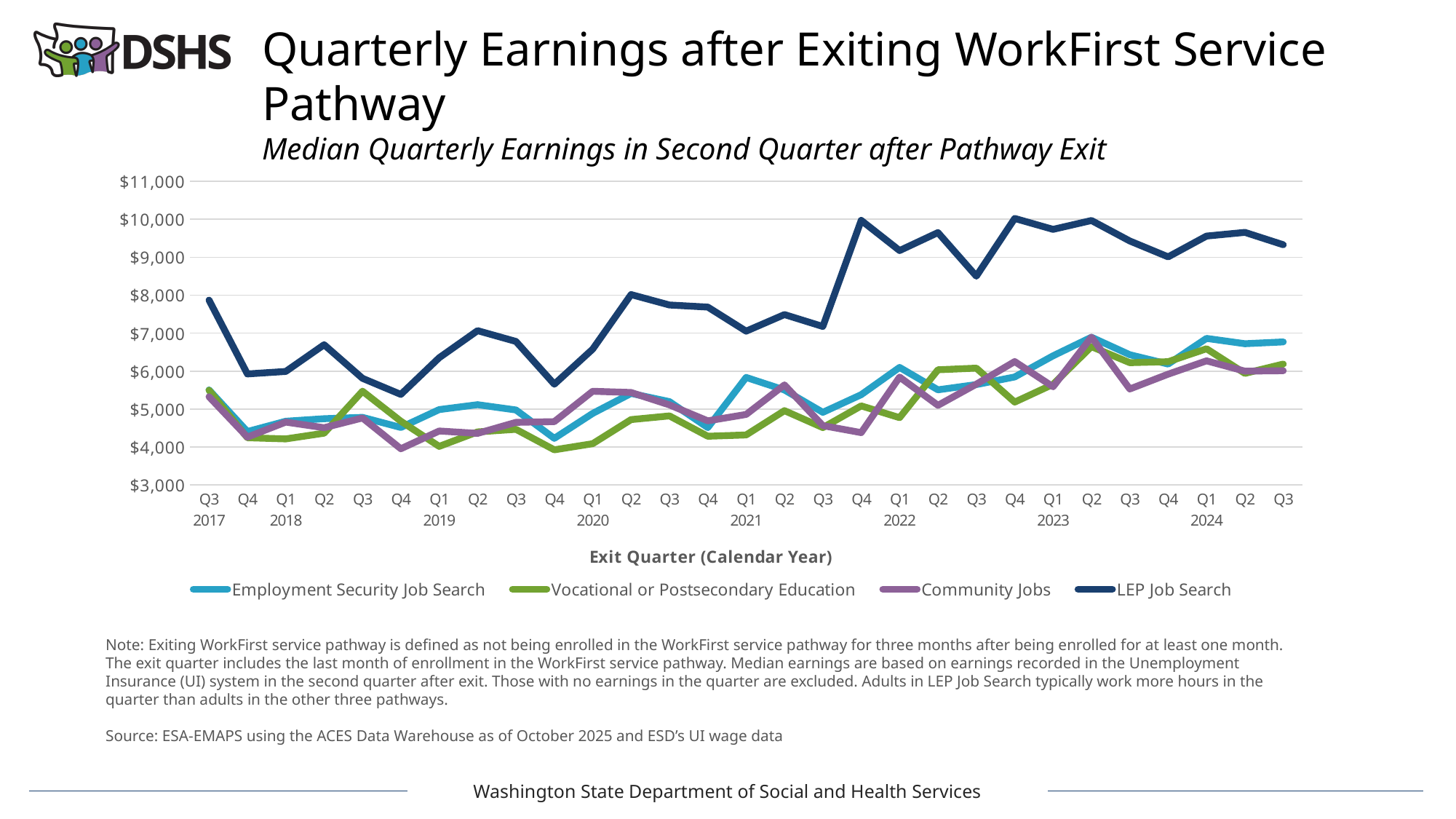
Is the value for LEP Job Search at Q3 2022 greater or less than $8,000? greater What kind of chart is shown on the slide? Line chart Which series has the lowest value at Q4 2019? Vocational or Postsecondary Education How many exit quarters are plotted along the x axis? 29 Is the value for Community Jobs at Q4 2021 greater or less than $5,000? less Is the value for Employment Security Job Search at Q3 2024 greater or less than $6,000? greater Does the LEP Job Search line generally rise or fall from Q3 2017 to Q3 2024? Rise How many series does the legend list? 4 At Q3 2024, which is larger: LEP Job Search or Employment Security Job Search? LEP Job Search Which series has the highest median quarterly earnings across the whole period? LEP Job Search What is the title of the x axis? Exit Quarter (Calendar Year)